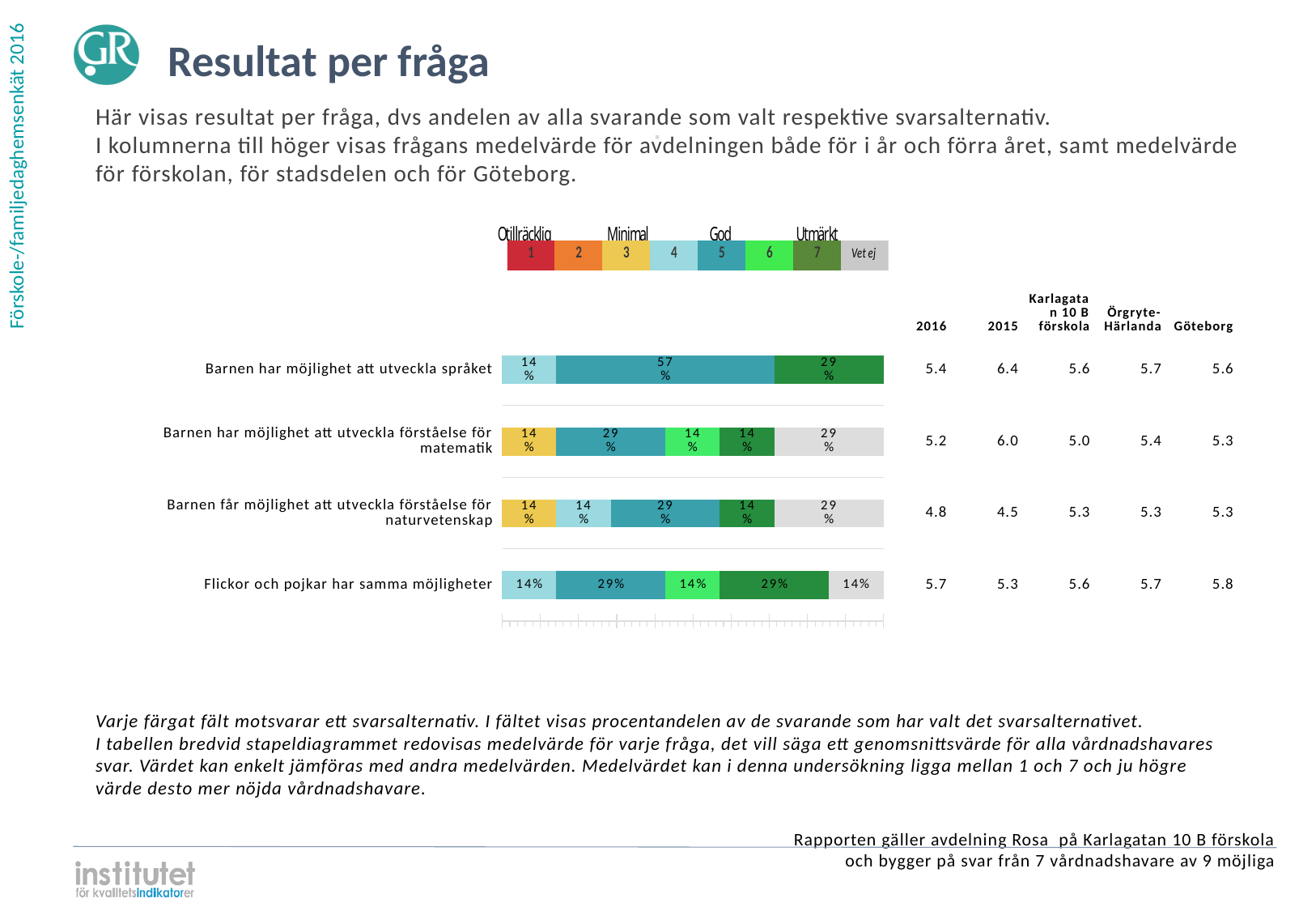
Which question has the lowest 2016 mean value in the table next to the chart? Barnen får möjlighet att utveckla förståelse för naturvetenskap How many response options does the legend above the chart list, including 'Vet ej'? 8 Which question has the largest single segment in its bar? Barnen har möjlighet att utveckla språket What is the difference between the option 5 share for 'Barnen har möjlighet att utveckla språket' (57%) and the option 5 share for 'Flickor och pojkar har samma möjligheter' (29%)? 28% What is the 2016 mean value shown for 'Barnen får möjlighet att utveckla förståelse för naturvetenskap'? 4.8 What kind of chart is shown on the slide? Stacked bar chart What is the 2015 mean value shown for 'Barnen har möjlighet att utveckla språket'? 6.4 What percentage of respondents chose option 5 (teal) for 'Barnen har möjlighet att utveckla språket'? 57% What percentage of respondents chose option 7 (dark green) for 'Flickor och pojkar har samma möjligheter'? 29% How many questions (categories) are plotted in the bar chart? 4 What percentage of respondents answered 'Vet ej' (grey) for 'Barnen har möjlighet att utveckla förståelse för matematik'? 29% Which is larger: the 'Vet ej' share for 'Barnen får möjlighet att utveckla förståelse för naturvetenskap' or the 'Vet ej' share for 'Flickor och pojkar har samma möjligheter'? Barnen får möjlighet att utveckla förståelse för naturvetenskap